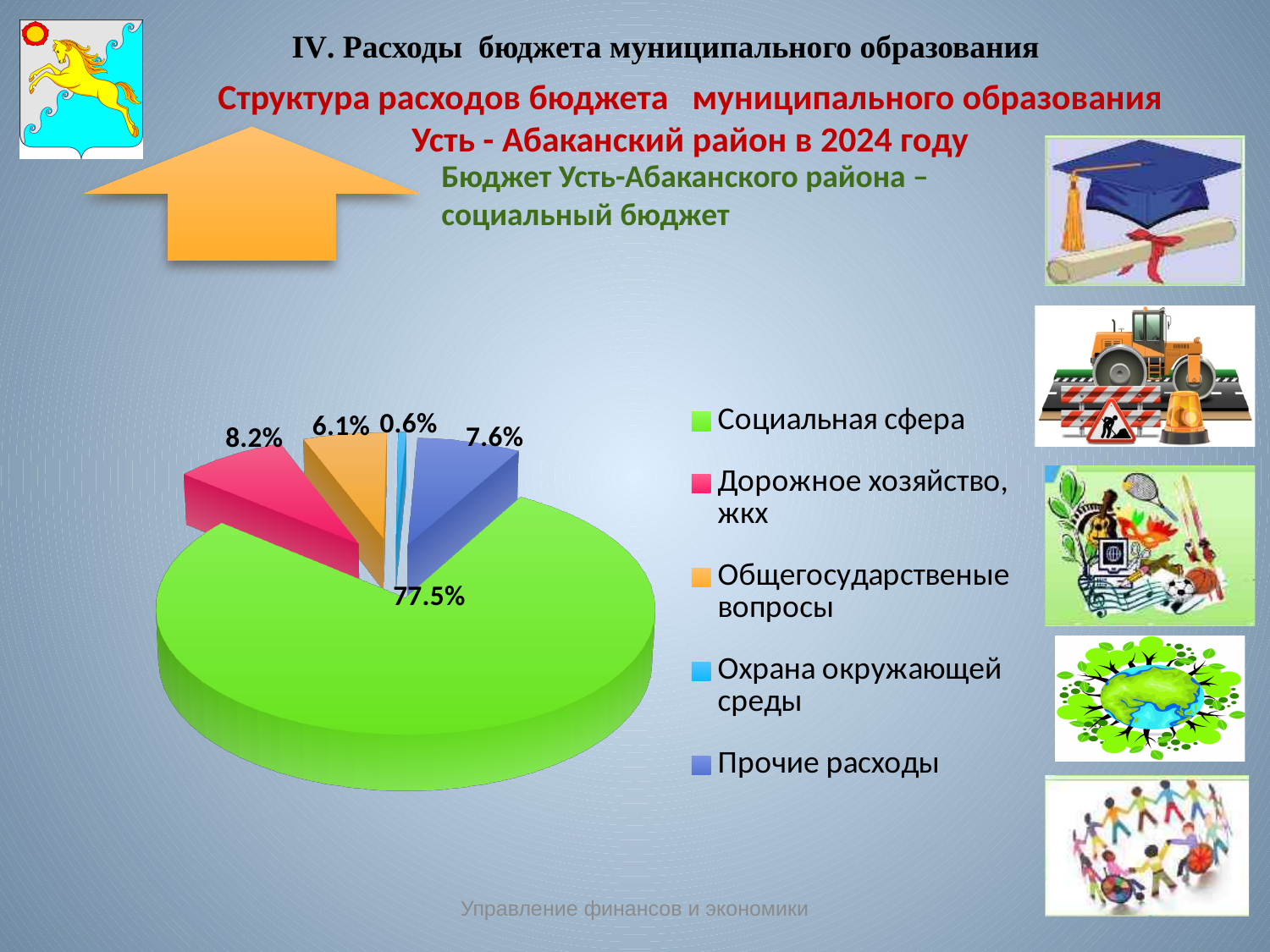
How many categories does the legend list? 5 What kind of chart is shown on the slide? pie chart What is the value for Общегосударственые вопросы? 6.1% What is the value for Дорожное хозяйство, жкх? 8.2% What share of the pie does Социальная сфера have? 77.5% What is the value for Прочие расходы? 7.6% Which category has the largest slice of the pie? Социальная сфера Which category has the smallest slice of the pie? Охрана окружающей среды What is the value for Охрана окружающей среды? 0.6% Which is larger: Общегосударственые вопросы or Прочие расходы? Прочие расходы What is the difference between the values for Дорожное хозяйство, жкх and Прочие расходы? 0.6% What colour is the slice for Социальная сфера? green